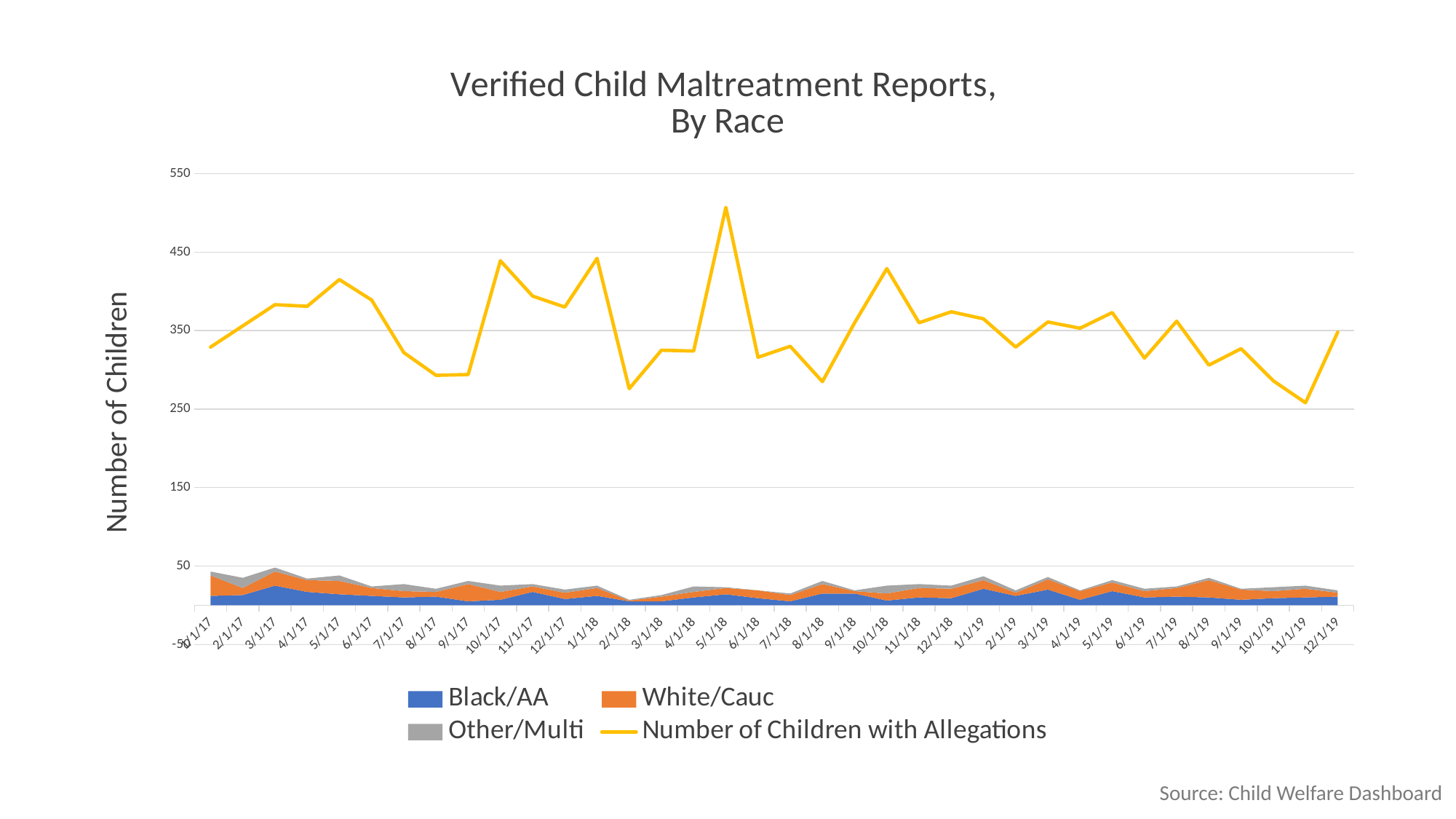
How many series does the chart's legend list? 4 Is the Number of Children with Allegations at 10/1/17 greater or less than 350? greater Which date has the larger Number of Children with Allegations, 10/1/17 or 8/1/17? 10/1/17 Is the Number of Children with Allegations at 11/1/19 greater or less than 350? less Which date has the larger Number of Children with Allegations, 5/1/18 or 2/1/18? 5/1/18 Which series is drawn as the yellow line? Number of Children with Allegations How many monthly points are plotted along the x axis? 36 Is the Number of Children with Allegations at 5/1/18 greater or less than 450? greater What is the label on the vertical axis? Number of Children What is the title of the chart? Verified Child Maltreatment Reports, By Race At which date does the Number of Children with Allegations line reach its highest value? 5/1/18